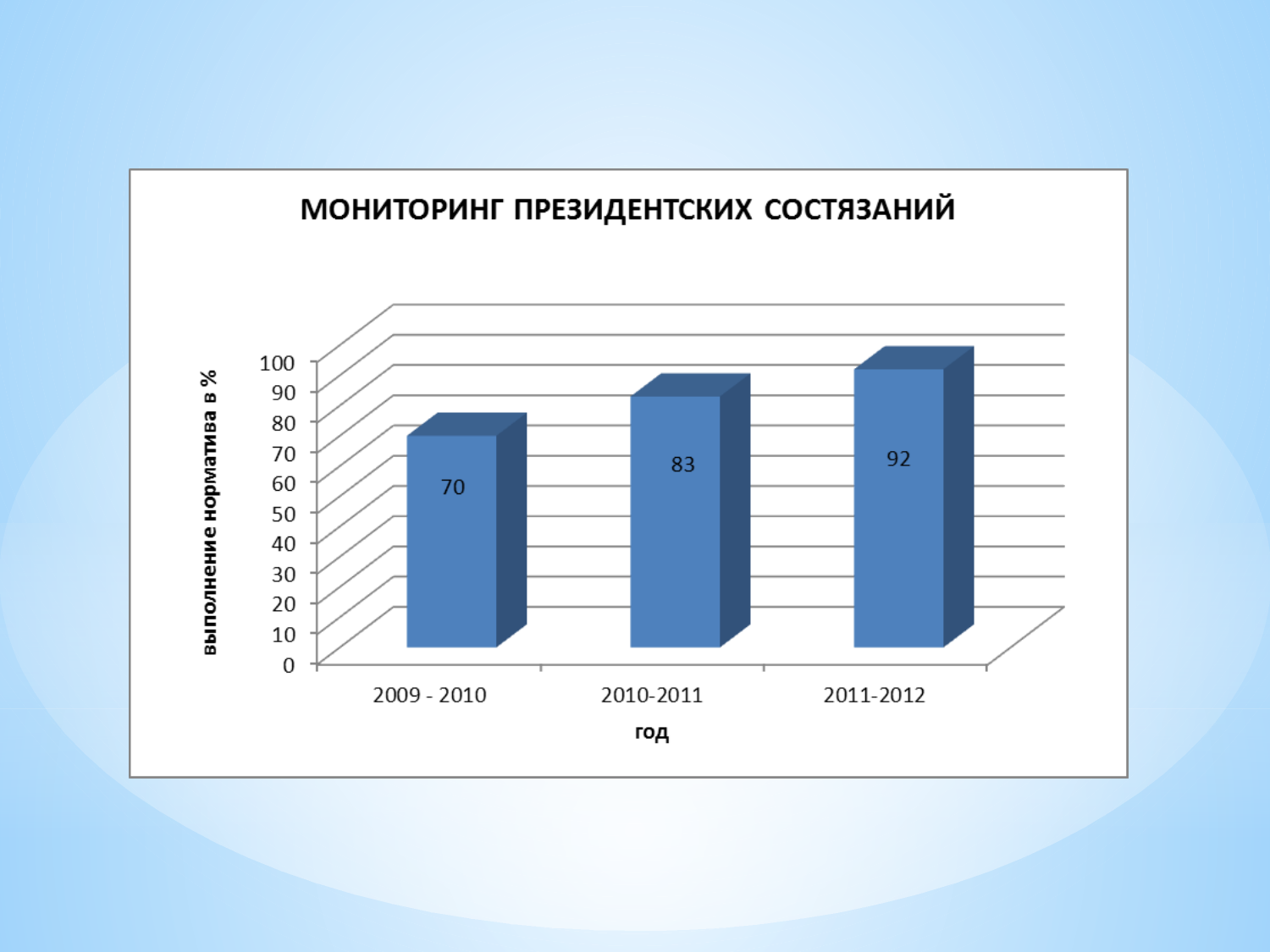
What is the value for 2011-2012? 92 What is the value for 2009 - 2010? 70 What is the value for 2010-2011? 83 How many years are shown on the x axis? 3 Do the values rise or fall from 2009 - 2010 to 2011-2012? Rise Which year has the highest value? 2011-2012 What is the difference between the values for 2010-2011 and 2009 - 2010? 13 Which year has the lowest value? 2009 - 2010 Which is larger, the value for 2010-2011 or the value for 2011-2012? 2011-2012 What is the difference between the values for 2011-2012 and 2009 - 2010? 22 What kind of chart is shown on the slide? Bar chart What is the title of the chart? МОНИТОРИНГ ПРЕЗИДЕНТСКИХ СОСТЯЗАНИЙ